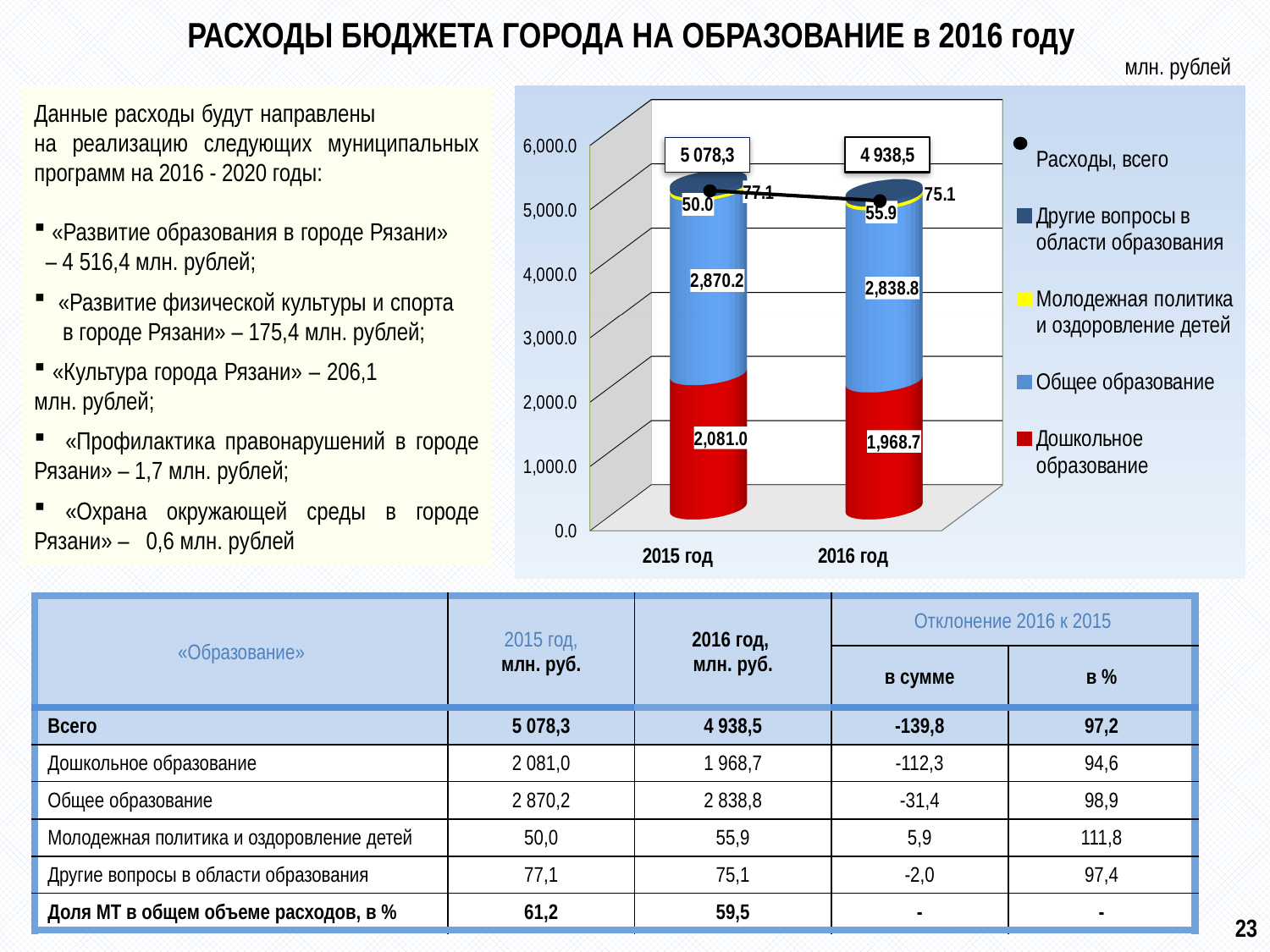
What is the value for Молодежная политика и оздоровление детей in 2016 год? 55.9 What is the value for Другие вопросы в области образования in 2015 год? 77.1 What type of chart is shown on the slide? stacked bar chart What is the difference between the Дошкольное образование values for 2015 год and 2016 год? 112.3 Which series is shown in red in the chart? Дошкольное образование What is the value for Общее образование in 2016 год? 2,838.8 How many entries does the chart legend list? 5 Which year has the higher total expenditure, 2015 год or 2016 год? 2015 год How many categories are shown on the x axis of the chart? 2 Does the total expenditure rise or fall from 2015 год to 2016 год? fall What is the value for Дошкольное образование in 2015 год? 2,081.0 What is the total (Расходы, всего) shown for 2016 год? 4 938,5